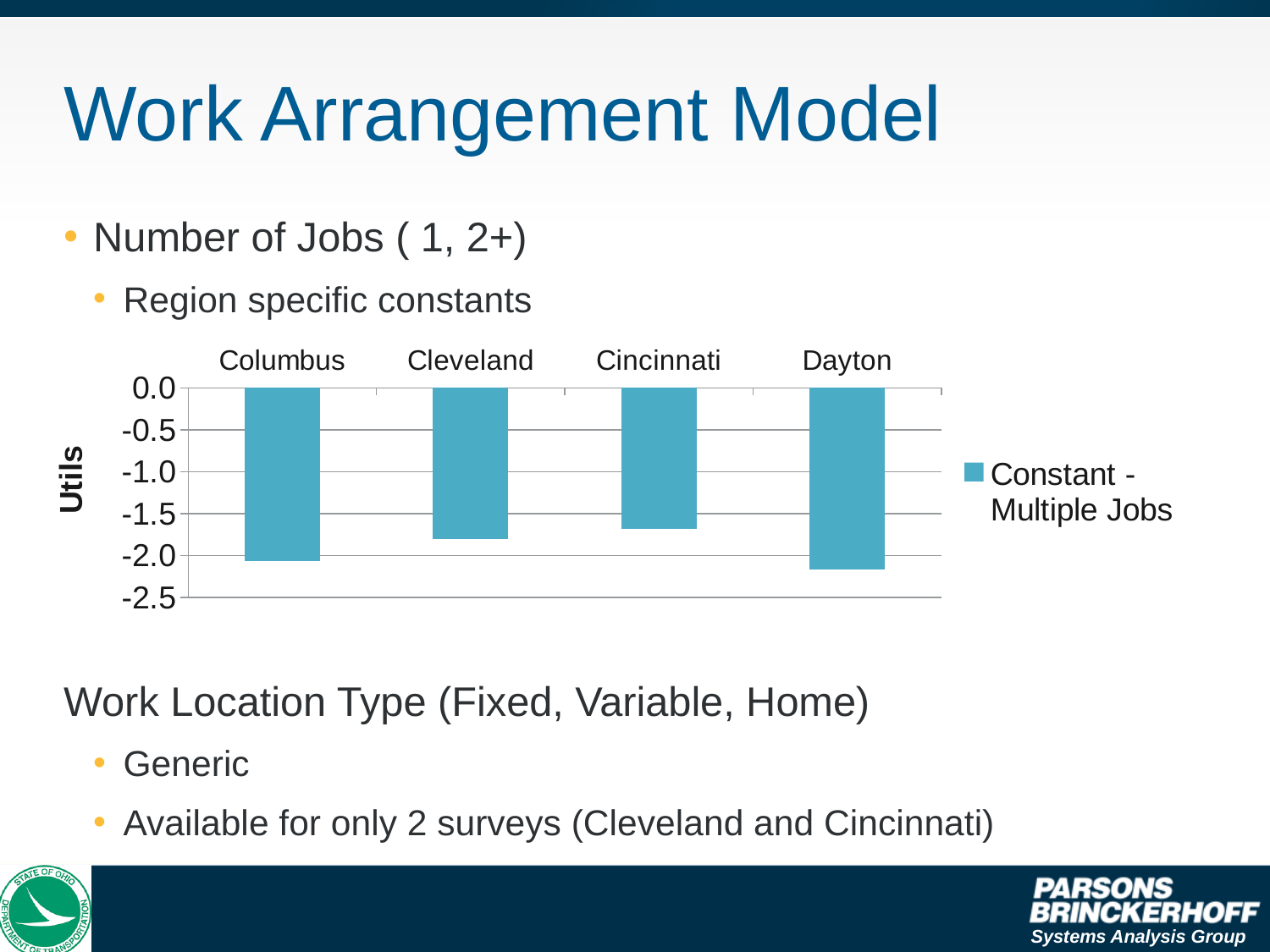
Are all the plotted constants in the chart positive or negative? negative Is the value for Cincinnati greater or less than -1.5? less What kind of chart is shown on the slide? bar chart What is the legend entry for the series in the chart? Constant - Multiple Jobs How many regions are plotted in the chart? 4 Is the value for Cleveland greater or less than -2.0? greater Is the value for Dayton greater or less than -2.0? less How many series does the chart legend list? 1 What is the label on the vertical axis of the chart? Utils Which has the lower (more negative) value, Cincinnati or Dayton? Dayton Which has the larger (less negative) value, Columbus or Cleveland? Cleveland